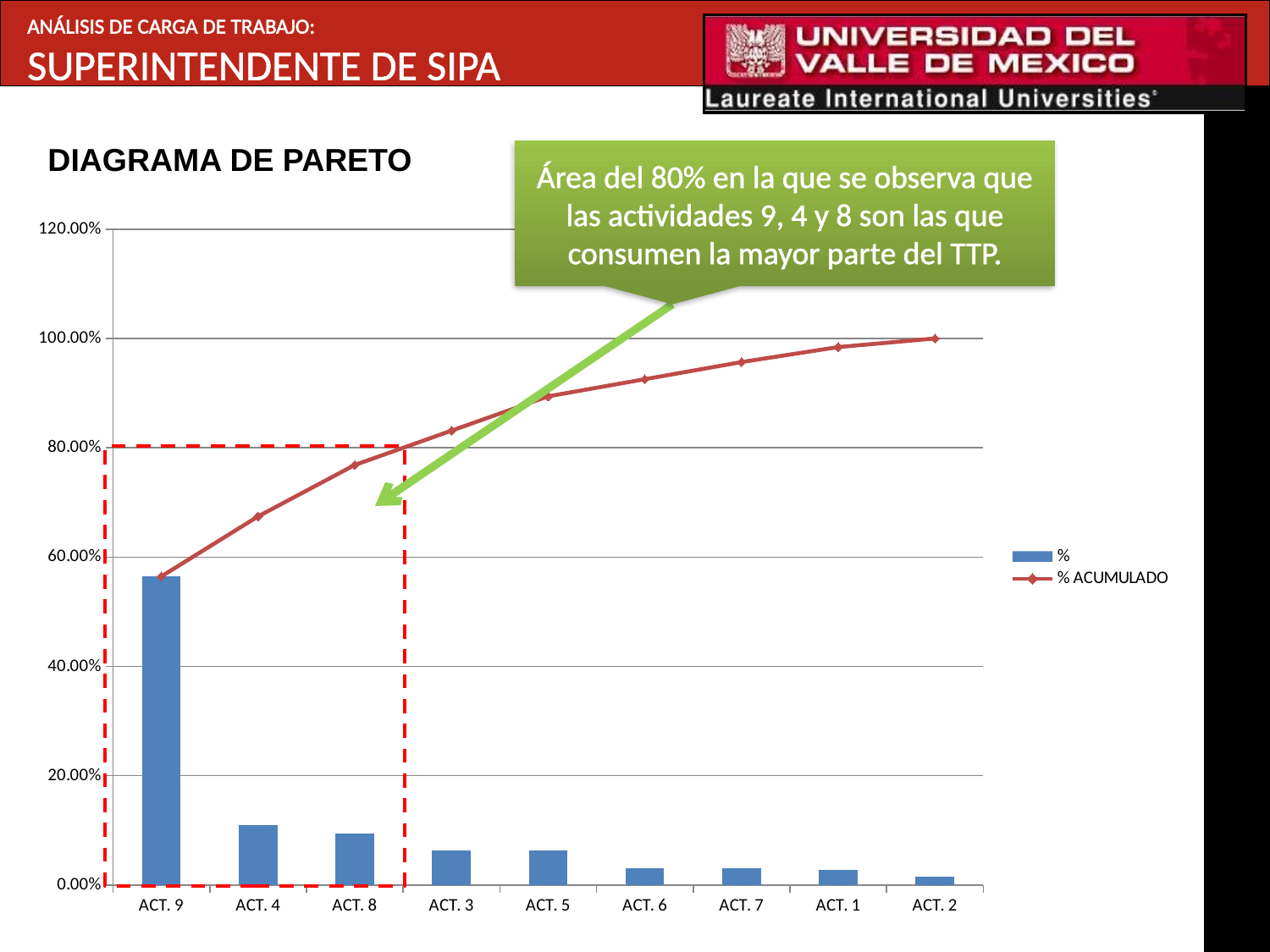
How many series does the chart legend list? 2 What is the title of the chart? DIAGRAMA DE PARETO Is the % value for ACT. 9 greater or less than 40.00%? greater Which activity has the highest % bar? ACT. 9 Which has the larger % bar, ACT. 9 or ACT. 4? ACT. 9 What is the % ACUMULADO value at ACT. 2? 100.00% Does the % ACUMULADO line rise or fall from ACT. 9 to ACT. 2? rise Is the % ACUMULADO value at ACT. 3 greater or less than 80.00%? greater Is the % ACUMULADO value at ACT. 8 greater or less than 80.00%? less Which activity has the lowest % bar? ACT. 2 How many activity categories are shown on the x axis? 9